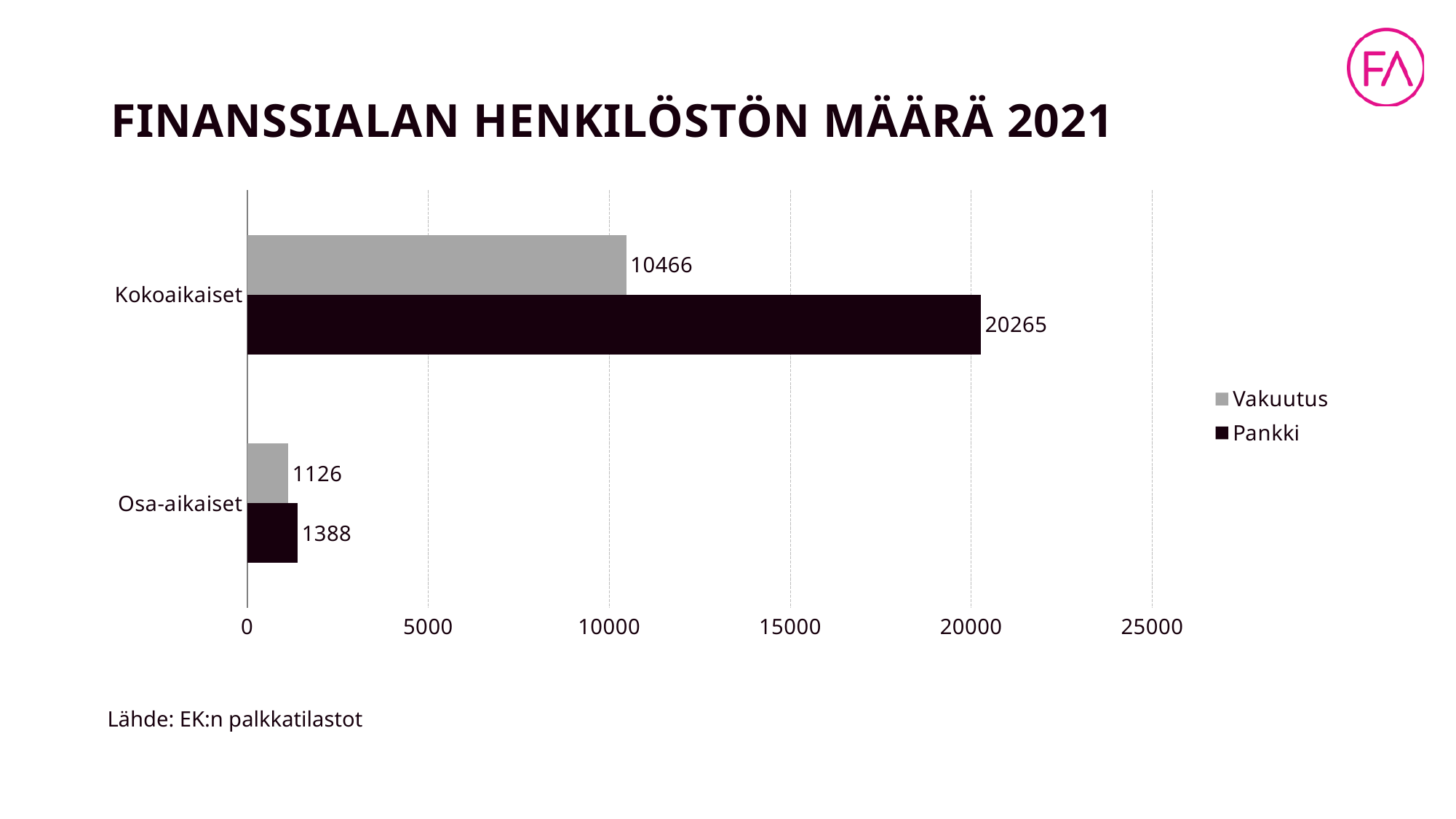
What is the difference between the Pankki and Vakuutus values for Kokoaikaiset? 9799 What is the Vakuutus value for Osa-aikaiset? 1126 What is the Pankki value for Osa-aikaiset? 1388 Which category has the lowest Vakuutus value? Osa-aikaiset What kind of chart is shown on the slide? bar chart Is the Pankki value for Kokoaikaiset greater or less than 20000? greater What is the Vakuutus value for Kokoaikaiset? 10466 Which is larger for Osa-aikaiset, Vakuutus or Pankki? Pankki What is the Pankki value for Kokoaikaiset? 20265 Which category has the highest Pankki value? Kokoaikaiset What is the difference between the Pankki and Vakuutus values for Osa-aikaiset? 262 How many series does the legend list? 2